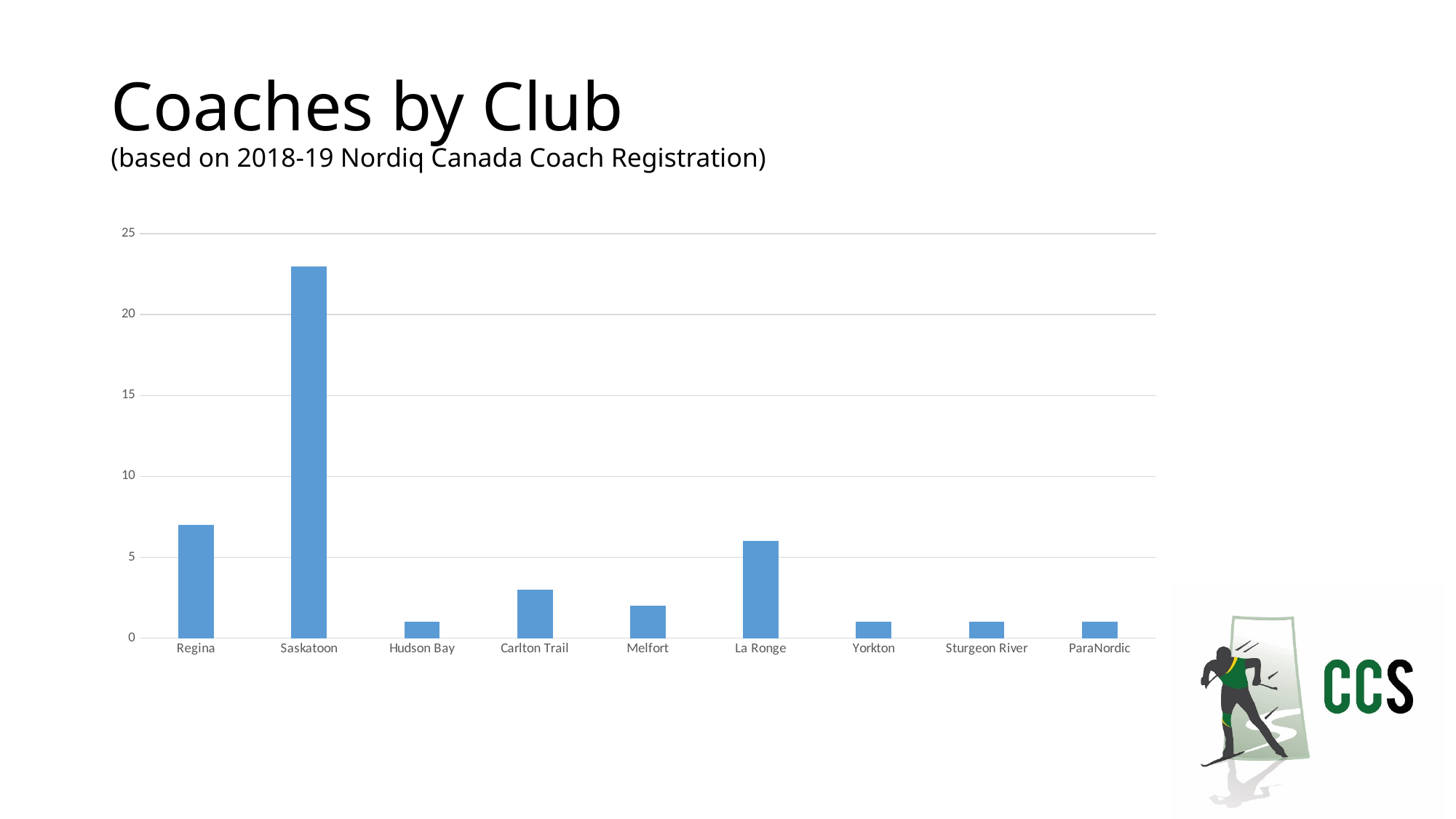
Is the value for Carlton Trail greater or less than 5? less Is the value for Hudson Bay greater or less than 5? less According to the subtitle, what is the chart based on? 2018-19 Nordiq Canada Coach Registration What is the title of the chart slide? Coaches by Club How many clubs are shown on the x axis of the chart? 9 Is the value for Regina greater or less than 10? less Which club has the highest number of coaches? Saskatoon Which has more coaches, Saskatoon or Regina? Saskatoon Which has more coaches, La Ronge or Melfort? La Ronge What kind of chart is shown on the slide? Bar chart